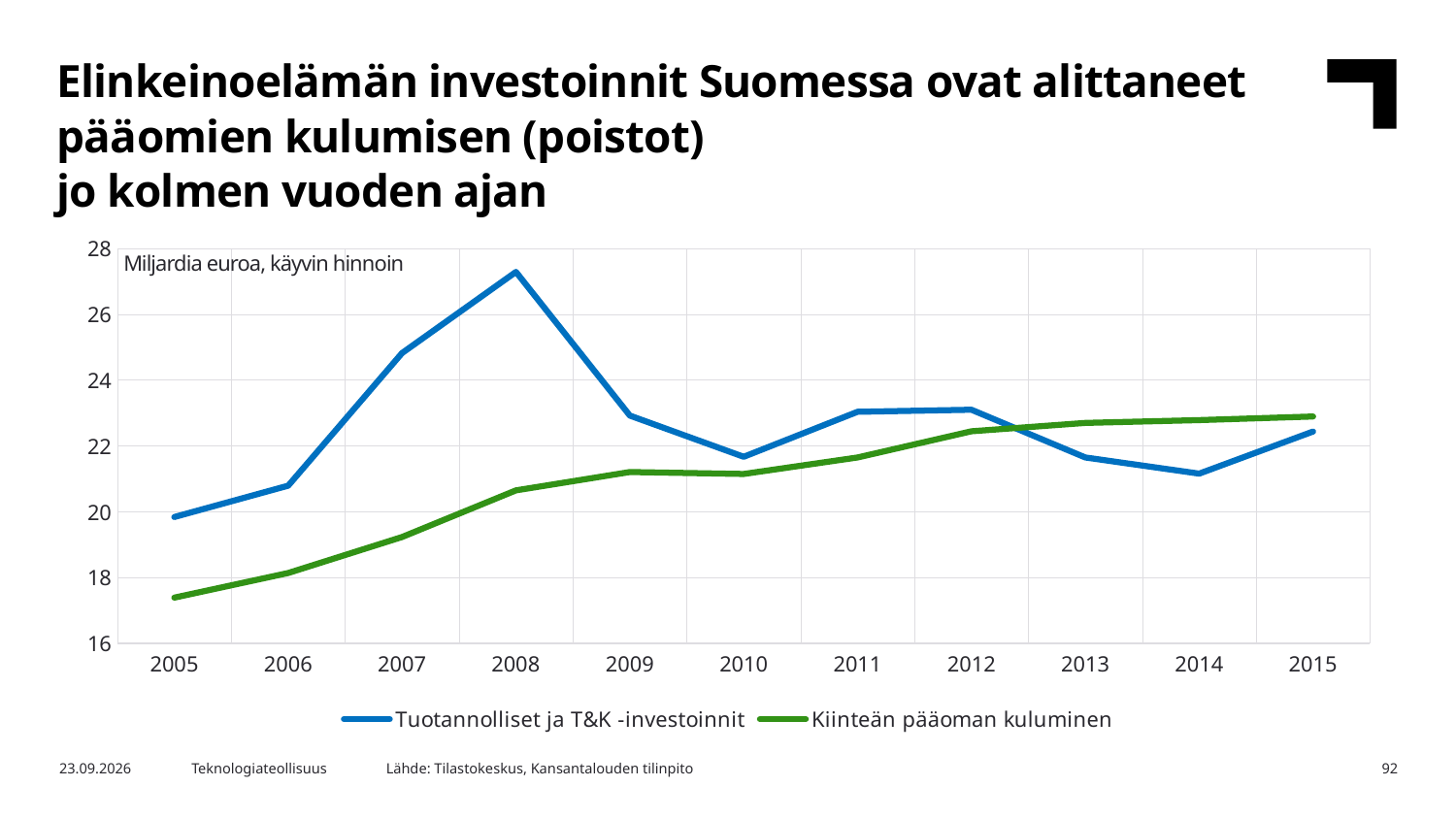
How many series does the legend list? 2 In 2014, which series has the higher value: 'Tuotannolliset ja T&K -investoinnit' or 'Kiinteän pääoman kuluminen'? Kiinteän pääoman kuluminen What unit label is shown in the top-left corner of the chart area? Miljardia euroa, käyvin hinnoin What kind of chart is shown on the slide? Line chart In 2008, which series has the higher value: 'Tuotannolliset ja T&K -investoinnit' or 'Kiinteän pääoman kuluminen'? Tuotannolliset ja T&K -investoinnit In which year does the series 'Tuotannolliset ja T&K -investoinnit' reach its highest value? 2008 Is the value for 'Kiinteän pääoman kuluminen' in 2005 greater or less than 18? less In which year is the series 'Kiinteän pääoman kuluminen' at its lowest? 2005 Does the series 'Kiinteän pääoman kuluminen' generally rise or fall from 2005 to 2015? Rise Is the value for 'Tuotannolliset ja T&K -investoinnit' in 2008 greater or less than 26? greater Is the value for 'Tuotannolliset ja T&K -investoinnit' in 2007 greater or less than 24? greater How many years are shown on the x axis? 11